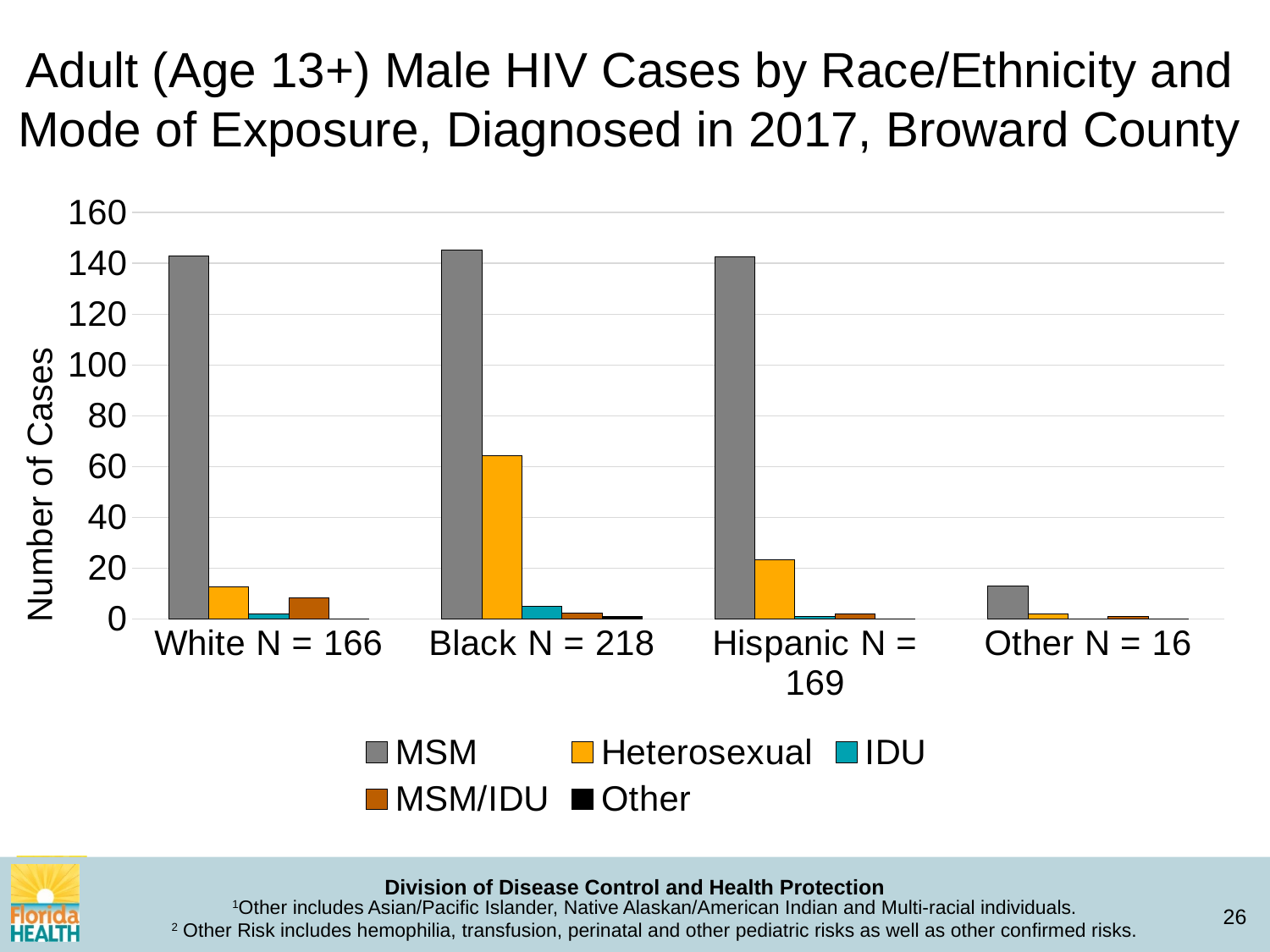
Is the Heterosexual value for Black N = 218 greater or less than 40? greater Is the MSM value for White N = 166 greater or less than 120? greater Which is larger for Black N = 218: the Heterosexual value or the IDU value? Heterosexual What kind of chart is shown on the slide? bar chart Is the Heterosexual value for Hispanic N = 169 greater or less than 40? less How many series does the legend list? 5 Which race/ethnicity group has the highest Heterosexual value? Black N = 218 How many race/ethnicity groups are shown on the x axis? 4 Which is larger: the Heterosexual value for Black N = 218 or the Heterosexual value for White N = 166? Black N = 218 Which race/ethnicity group has the lowest MSM value? Other N = 16 What is the label of the y axis? Number of Cases